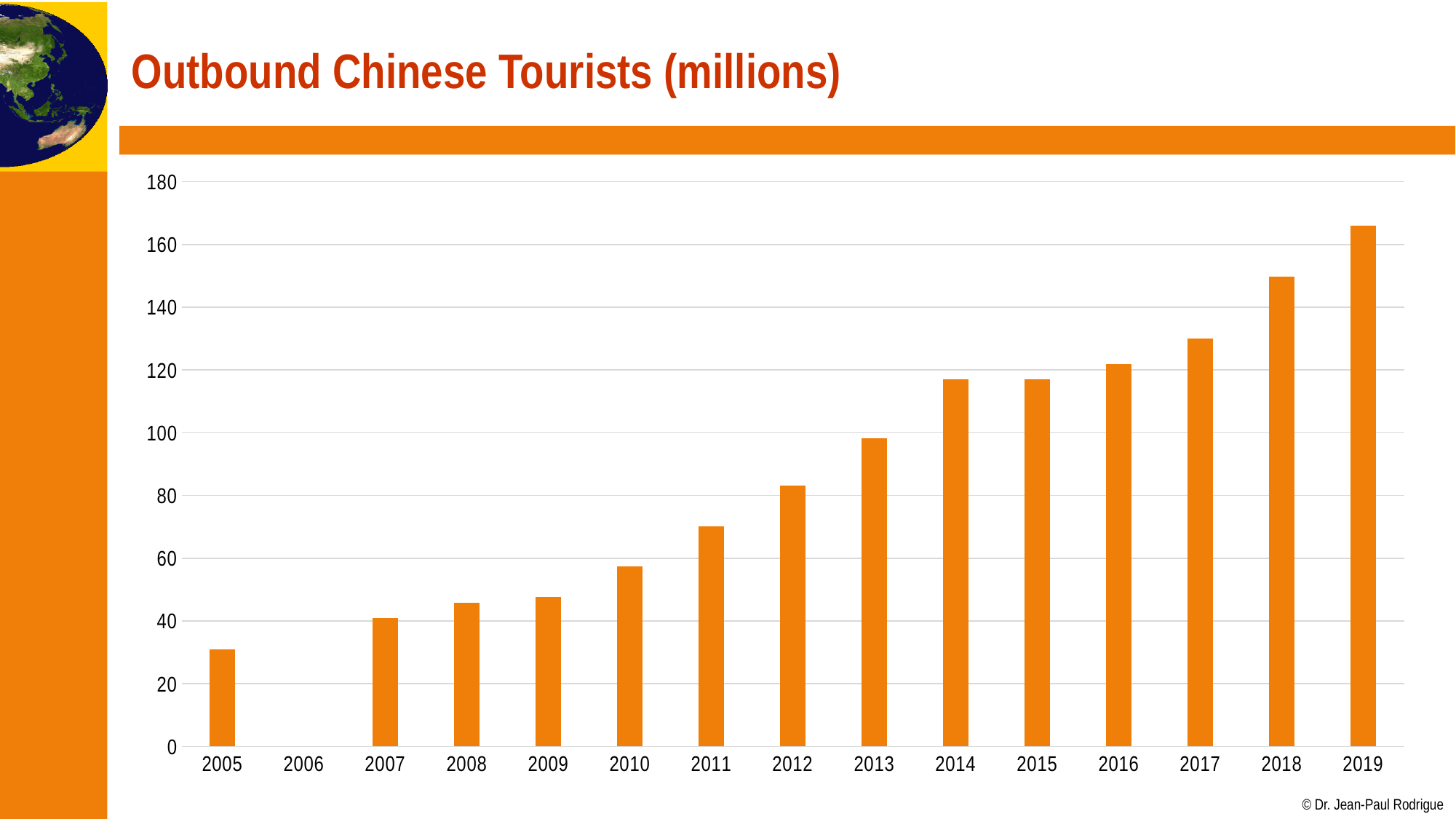
Is the value for 2013 greater or less than 100? less What is the title of the chart? Outbound Chinese Tourists (millions) Is the value for 2010 greater or less than 60? less What kind of chart is shown on the slide? bar chart Do the values generally rise or fall from 2005 to 2019? rise Is the value for 2019 greater or less than 160? greater How many year labels are shown on the x axis? 15 Which year has the larger value, 2011 or 2012? 2012 Which year has the tallest bar? 2019 Which year has the larger value, 2017 or 2018? 2018 Which year on the x axis has no bar shown? 2006